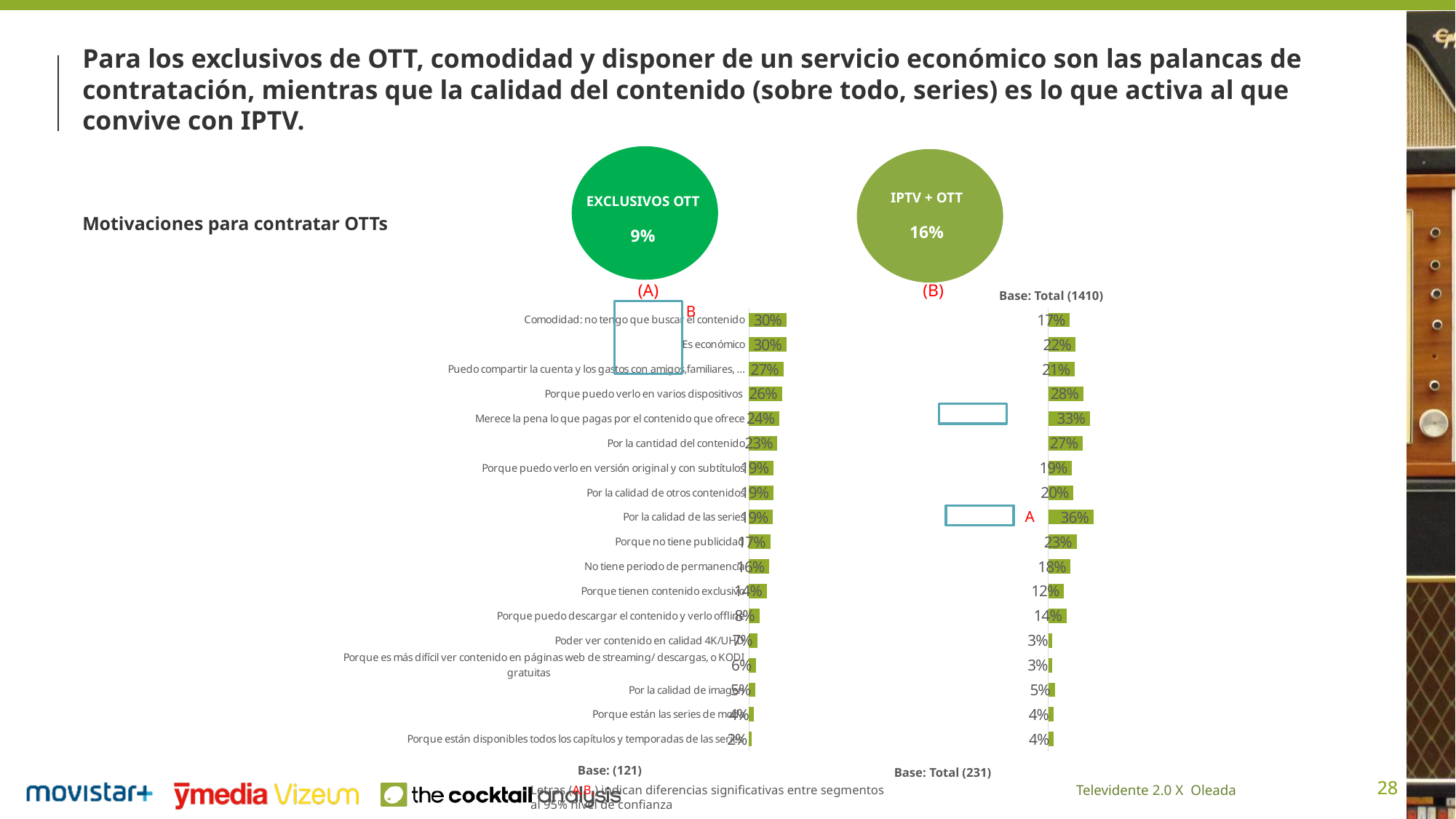
For 'Comodidad: no tengo que buscar el contenido', which segment has the larger value, EXCLUSIVOS OTT or IPTV + OTT? EXCLUSIVOS OTT In the IPTV + OTT chart, which motivation has the highest value? Por la calidad de las series In the EXCLUSIVOS OTT chart, what is the value for 'Porque puedo descargar el contenido y verlo offline'? 8% How many motivation categories are listed in the charts? 18 In the IPTV + OTT chart, what is the value for 'Por la calidad de las series'? 36% In the EXCLUSIVOS OTT chart, which motivation has the lowest value? Porque están disponibles todos los capítulos y temporadas de las series What is the difference between the IPTV + OTT value and the EXCLUSIVOS OTT value for 'Porque puedo verlo en varios dispositivos'? 2% In the EXCLUSIVOS OTT chart, what is the value for 'Comodidad: no tengo que buscar el contenido'? 30% What is the difference between the EXCLUSIVOS OTT value and the IPTV + OTT value for 'Por la calidad de las series'? 17% In the IPTV + OTT chart, what is the value for 'Merece la pena lo que pagas por el contenido que ofrece'? 33% What base size is shown under the EXCLUSIVOS OTT chart? Base: (121) What kind of chart is used to show the motivations for contracting OTTs on this slide? bar chart